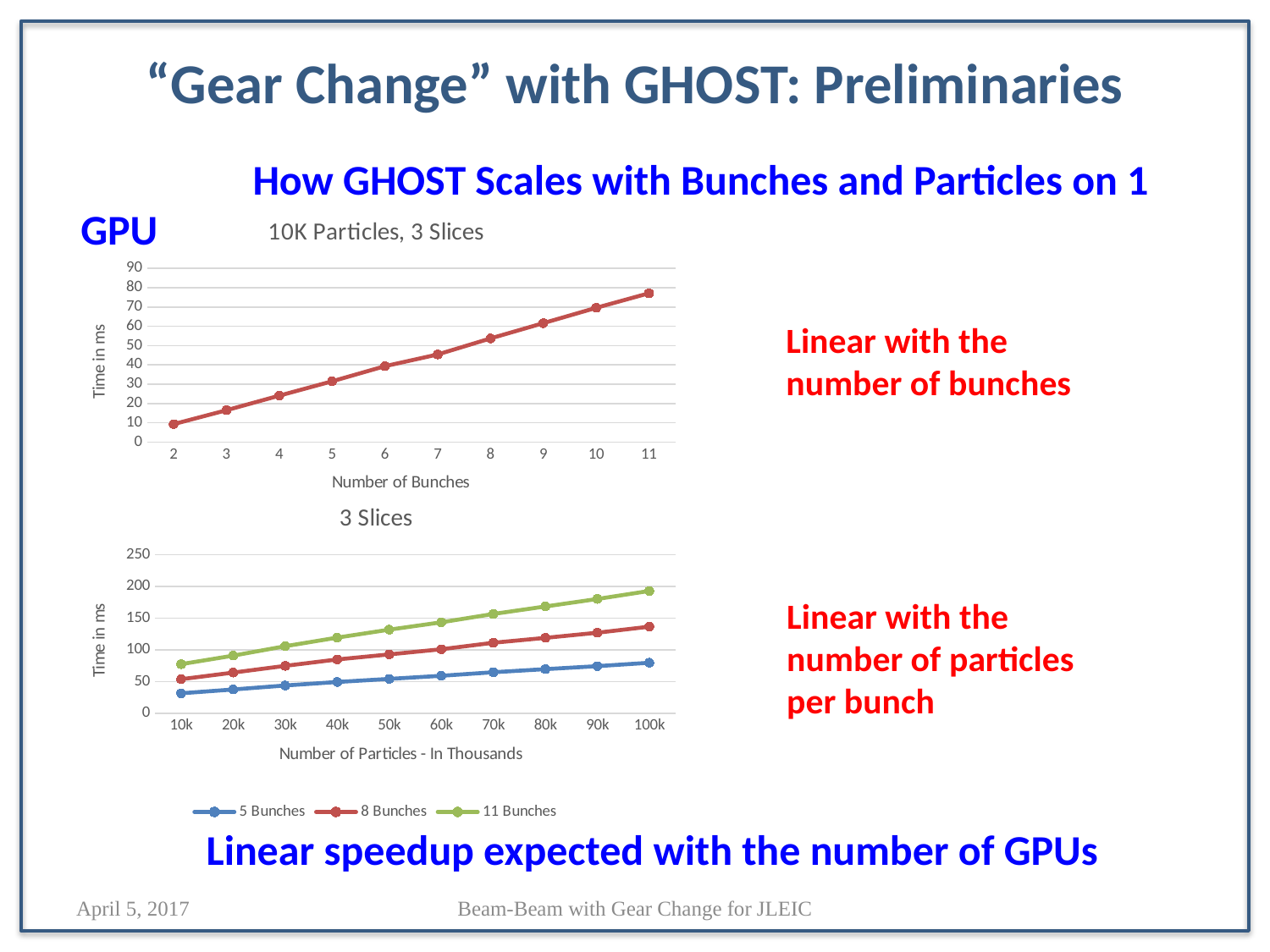
In the top chart (10K Particles, 3 Slices), does the time rise or fall as the number of bunches increases? rises In the bottom chart (3 Slices), is the time for 8 Bunches at 100k particles greater or less than 100 ms? greater In the bottom chart (3 Slices), which series has the highest time at 100k particles? 11 Bunches In the bottom chart (3 Slices), is the time for 5 Bunches at 10k particles greater or less than 50 ms? less In the top chart (10K Particles, 3 Slices), is the time for 11 bunches greater or less than 70 ms? greater In the bottom chart (3 Slices), how many series does the legend list? 3 In the top chart (10K Particles, 3 Slices), which number of bunches has the highest time? 11 What type of chart is the top chart titled "10K Particles, 3 Slices"? line chart What is the x-axis label of the bottom chart (3 Slices)? Number of Particles - In Thousands In the top chart (10K Particles, 3 Slices), how many data points are plotted along the Number of Bunches axis? 10 In the bottom chart (3 Slices), at 100k particles, which is larger: the time for 11 Bunches or for 5 Bunches? 11 Bunches